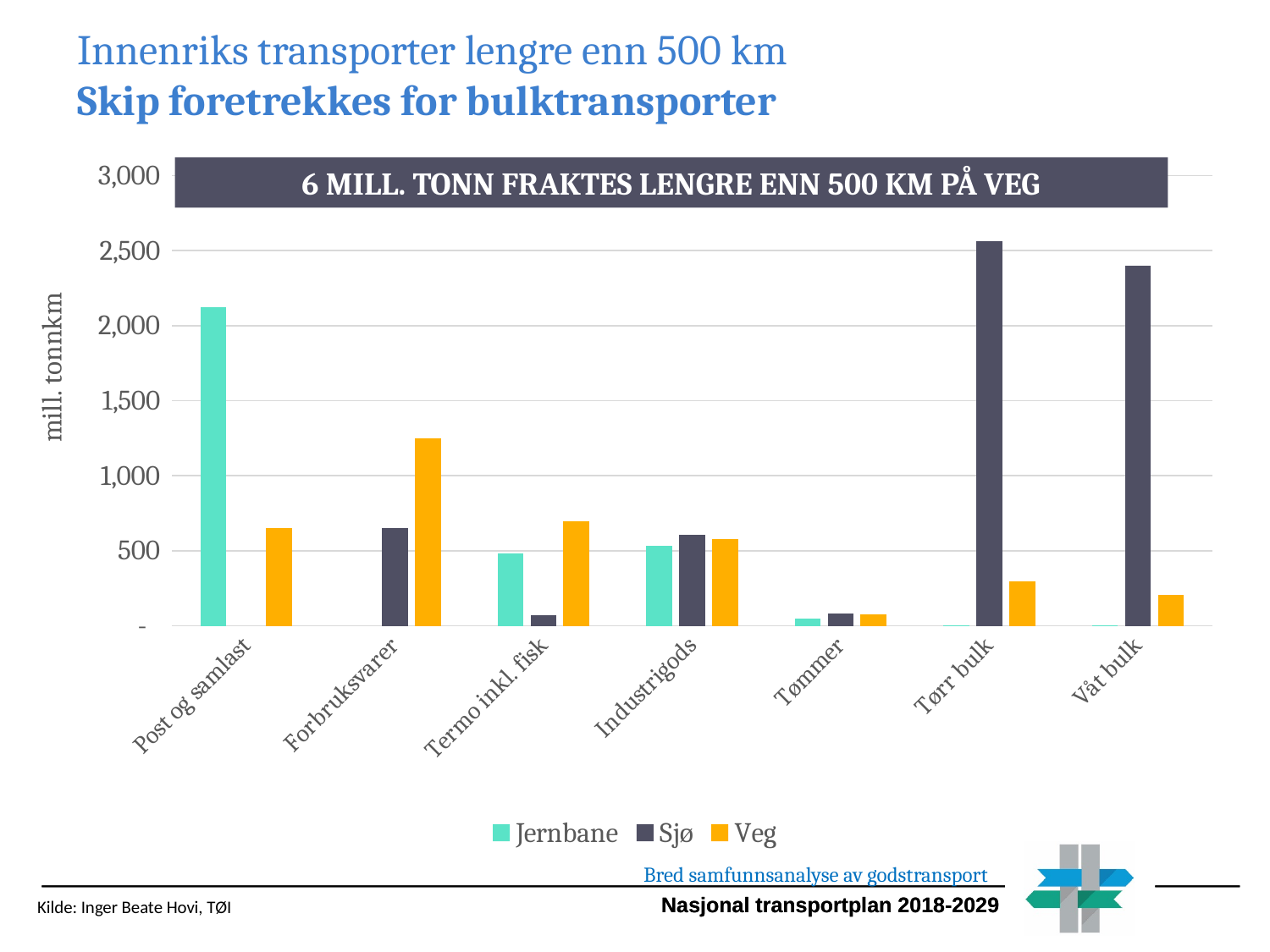
How many series does the legend list? 3 Which category has the highest Jernbane bar? Post og samlast For Termo inkl. fisk, which is larger: the Veg bar or the Jernbane bar? Veg How many categories are shown on the x axis? 7 Which category has the highest Sjø bar? Tørr bulk Is the Sjø value for Våt bulk greater or less than 2,500? less For Post og samlast, which is larger: the Jernbane bar or the Veg bar? Jernbane Is the Veg value for Forbruksvarer greater or less than 1,000? greater Which category has the highest Veg bar? Forbruksvarer What is the label on the y axis? mill. tonnkm What kind of chart is shown on the slide? bar chart Is the Jernbane value for Post og samlast greater or less than 2,000? greater